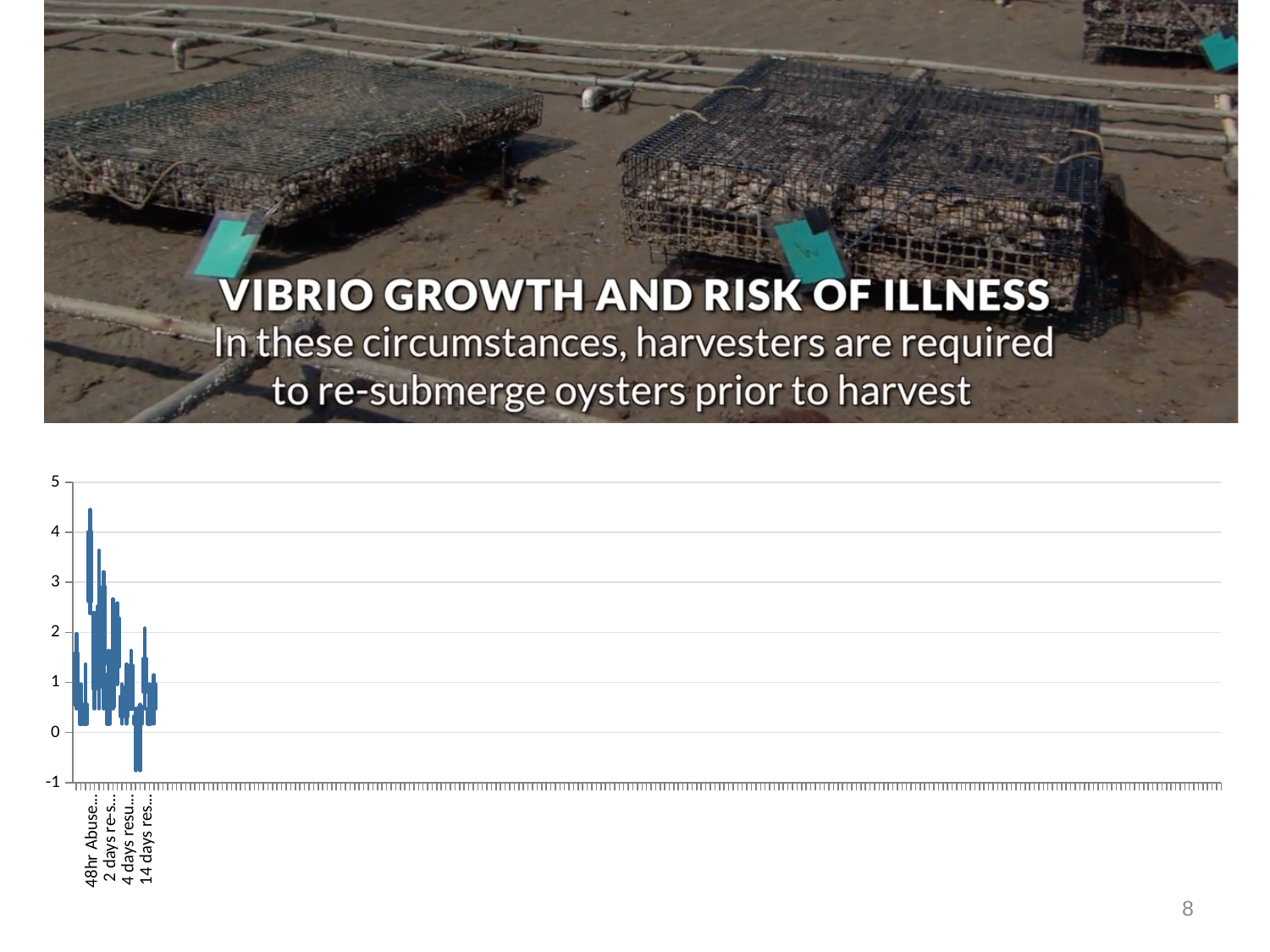
What is the lowest value labelled on the vertical axis of the chart? -1 Does the plotted line ever drop below -1 on the vertical axis? no What is the highest value labelled on the vertical axis of the chart? 5 What kind of chart is shown at the bottom of the slide? line chart Is the lowest point of the plotted line greater or less than 0? less Is the highest point of the plotted line greater or less than 4? greater What colour is the plotted line in the chart? blue